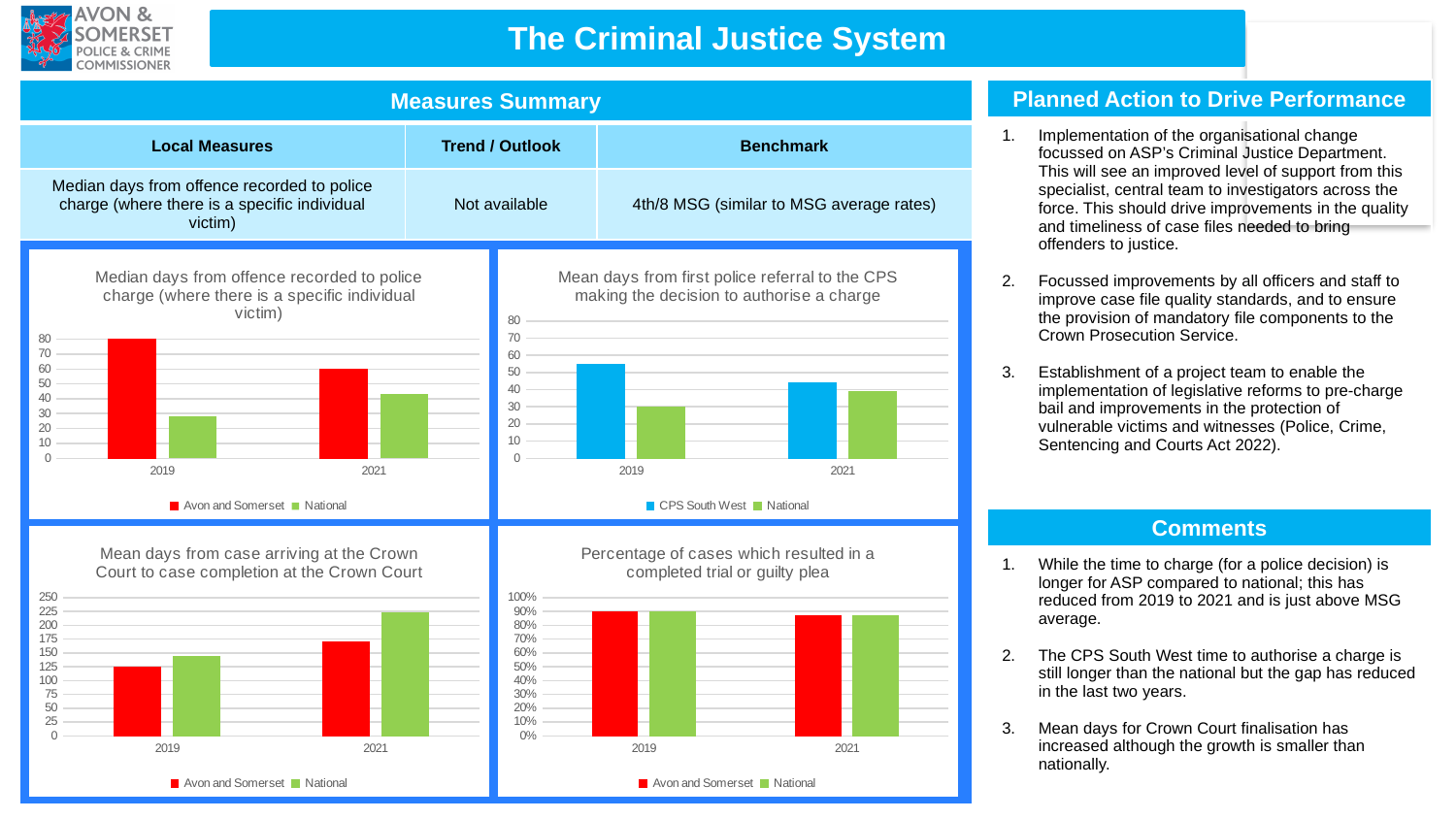
In the chart titled 'Percentage of cases which resulted in a completed trial or guilty plea', is the value for Avon and Somerset in 2019 greater or less than 80%? greater In the chart titled 'Mean days from first police referral to the CPS making the decision to authorise a charge', which series does the legend list alongside National? CPS South West How many series does the legend list in the chart titled 'Percentage of cases which resulted in a completed trial or guilty plea'? 2 In the chart titled 'Mean days from first police referral to the CPS making the decision to authorise a charge', does the National value rise or fall from 2019 to 2021? rise In the chart titled 'Median days from offence recorded to police charge', does the Avon and Somerset value rise or fall from 2019 to 2021? fall In the chart titled 'Median days from offence recorded to police charge', which is larger in 2021: Avon and Somerset or National? Avon and Somerset In the chart titled 'Median days from offence recorded to police charge', is the value for Avon and Somerset in 2019 greater or less than 70? greater In the chart titled 'Mean days from first police referral to the CPS making the decision to authorise a charge', is the value for CPS South West in 2019 greater or less than 50? greater In the chart titled 'Mean days from case arriving at the Crown Court to case completion at the Crown Court', which is larger in 2021: Avon and Somerset or National? National In the chart titled 'Mean days from case arriving at the Crown Court to case completion at the Crown Court', which bar is the lowest? Avon and Somerset 2019